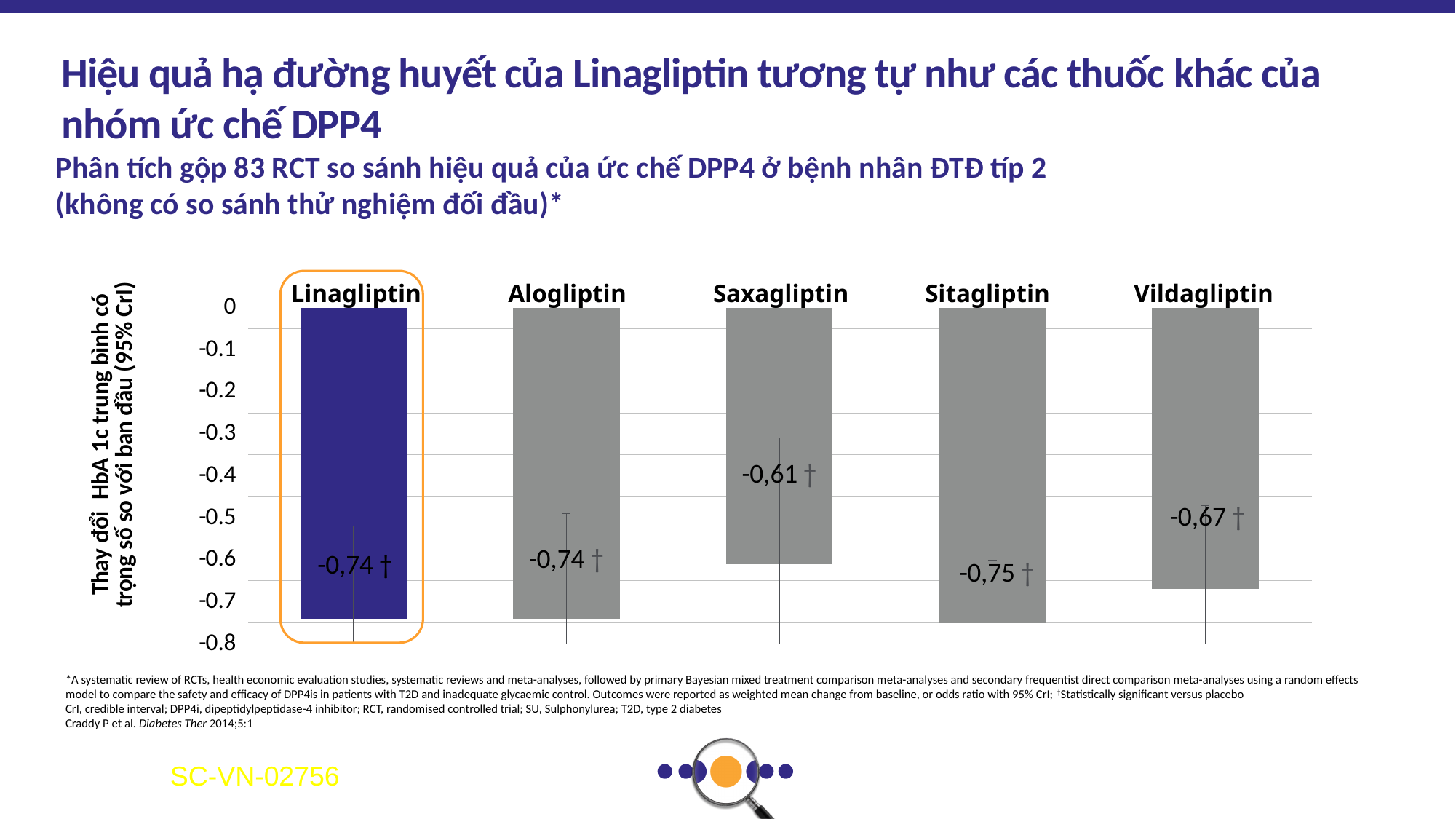
Which drug's bar is highlighted in a different colour (dark blue) from the others? Linagliptin What is the mean HbA1c change shown for Sitagliptin? -0,75 What kind of chart is shown on the slide? Bar chart How many drugs are plotted in the chart? 5 What is the difference between the HbA1c change for Sitagliptin and for Saxagliptin? 0,14 Which drug shows the largest HbA1c reduction (most negative value)? Sitagliptin What is the mean HbA1c change shown for Vildagliptin? -0,67 What is the mean HbA1c change shown for Linagliptin? -0,74 Which drug shows the smallest HbA1c reduction (least negative value)? Saxagliptin Which shows a larger HbA1c reduction, Saxagliptin or Vildagliptin? Vildagliptin What is the mean HbA1c change shown for Alogliptin? -0,74 What is the mean HbA1c change shown for Saxagliptin? -0,61